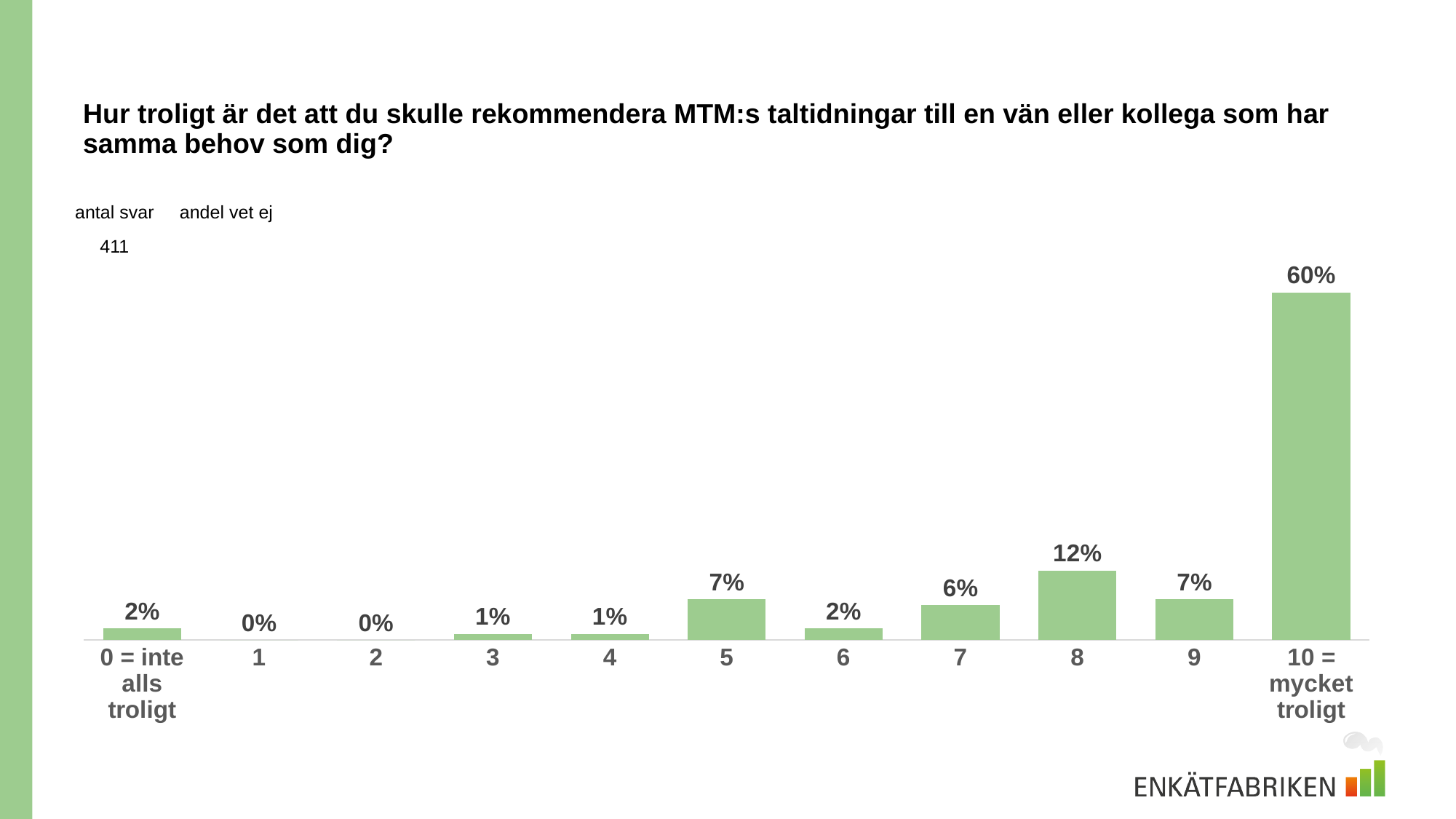
What is the value shown for category 8? 12% How many categories are shown on the x axis? 11 Which is larger, the value for category 7 or the value for category 6? 7 What is the number of responses (antal svar) shown on the slide? 411 What percentage of respondents answered "10 = mycket troligt"? 60% How many categories have a value of 0%? 2 What is the difference between the values for category 10 and category 8? 48% Which category has the highest value? 10 = mycket troligt What is the value shown for "0 = inte alls troligt"? 2% What is the difference between the values for category 8 and category 9? 5% What kind of chart is shown on the slide? bar chart What is the value shown for category 5? 7%